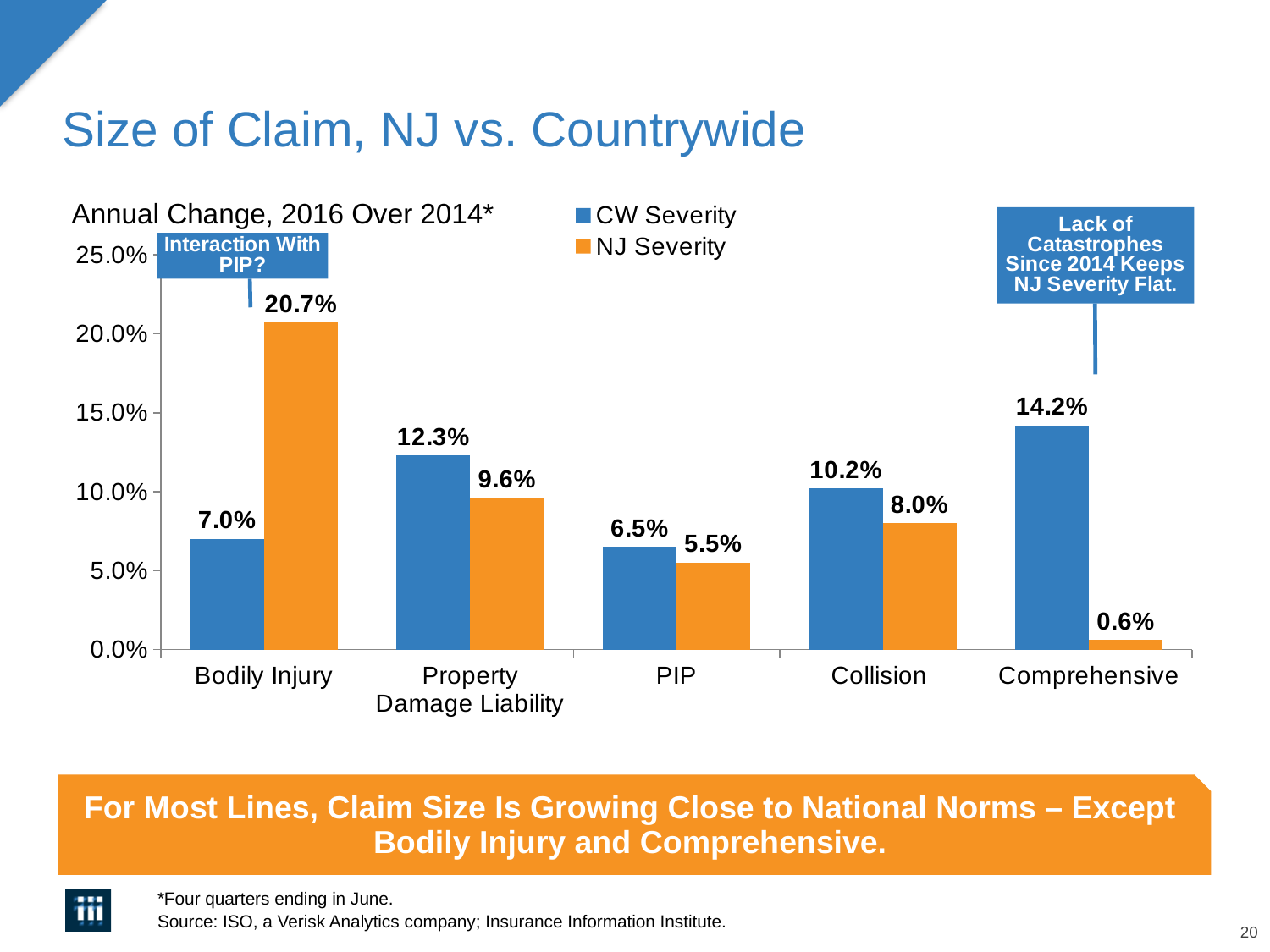
What is the subtitle shown above the chart? Annual Change, 2016 Over 2014* How many series does the legend list? 2 What is the difference between the CW Severity and NJ Severity values for Collision? 2.2% What is the difference between the NJ Severity and CW Severity values for Bodily Injury? 13.7% Which category has the lowest NJ Severity value? Comprehensive What is the NJ Severity value for Bodily Injury? 20.7% How many categories are shown on the x axis? 5 What is the CW Severity value for Comprehensive? 14.2% Which is larger for Property Damage Liability, CW Severity or NJ Severity? CW Severity Which category has the highest CW Severity value? Comprehensive What kind of chart is shown on the slide? Bar chart What is the NJ Severity value for PIP? 5.5%